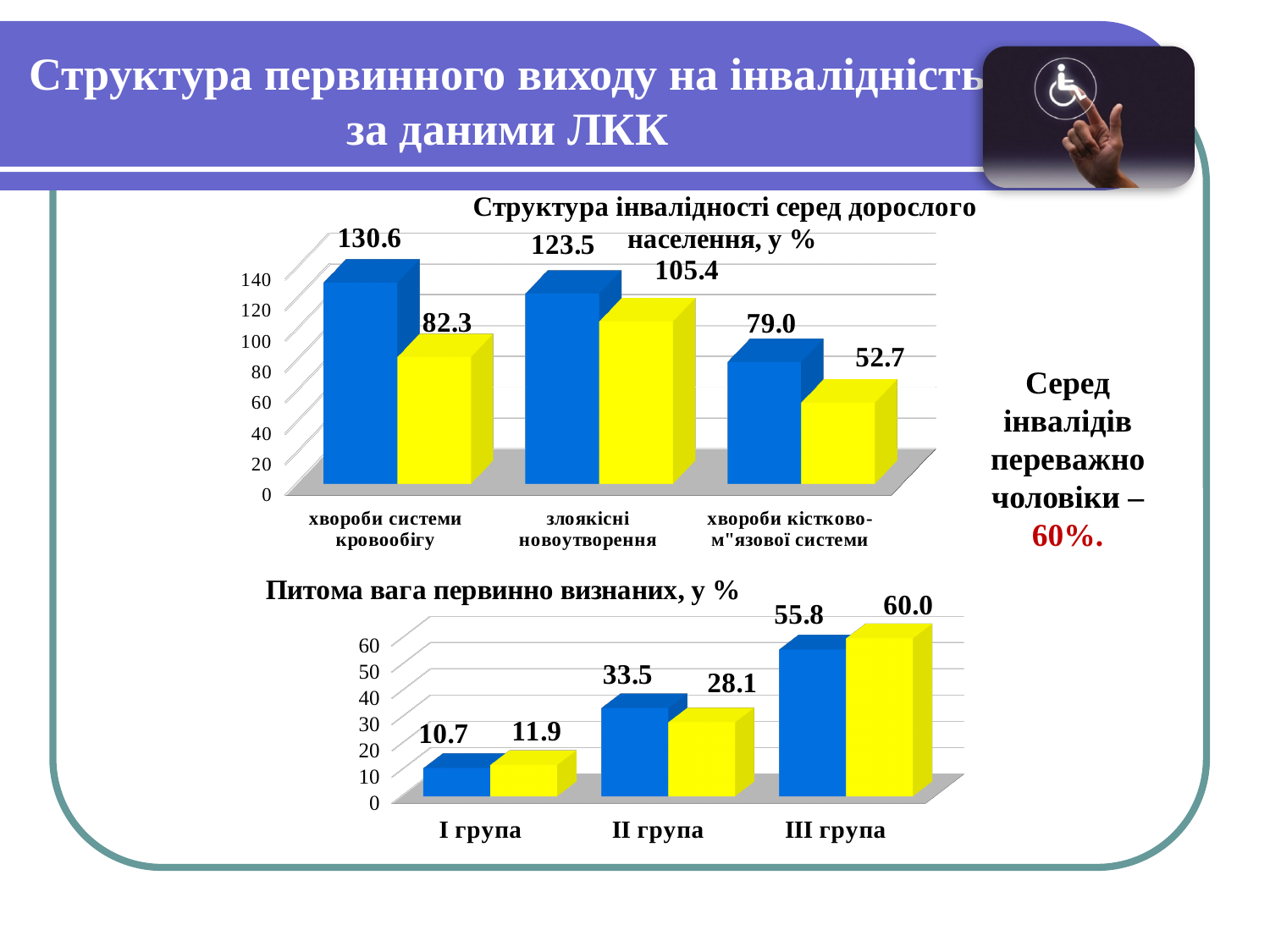
In the top chart 'Структура інвалідності серед дорослого населення, у %', what is the value of the yellow bar for 'злоякісні новоутворення'? 105.4 In the bottom chart 'Питома вага первинно визнаних, у %', what is the value of the yellow bar for 'III група'? 60.0 In the bottom chart 'Питома вага первинно визнаних, у %', which is larger for 'II група': the blue bar or the yellow bar? the blue bar In the top chart 'Структура інвалідності серед дорослого населення, у %', how many categories are shown on the x axis? 3 In the top chart 'Структура інвалідності серед дорослого населення, у %', is the blue bar for 'хвороби кістково-м"язової системи' greater or less than 100? less In the bottom chart 'Питома вага первинно визнаних, у %', what is the value of the blue bar for 'II група'? 33.5 In the top chart 'Структура інвалідності серед дорослого населення, у %', what is the difference between the blue and yellow bars for 'хвороби системи кровообігу'? 48.3 In the top chart 'Структура інвалідності серед дорослого населення, у %', what is the value of the blue bar for 'хвороби системи кровообігу'? 130.6 What type of chart is the bottom chart 'Питома вага первинно визнаних, у %'? bar chart In the top chart 'Структура інвалідності серед дорослого населення, у %', which category has the lowest yellow bar? хвороби кістково-м"язової системи In the bottom chart 'Питома вага первинно визнаних, у %', do the blue bar values rise or fall from 'I група' to 'III група'? rise In the bottom chart 'Питома вага первинно визнаних, у %', which group has the highest blue bar? III група